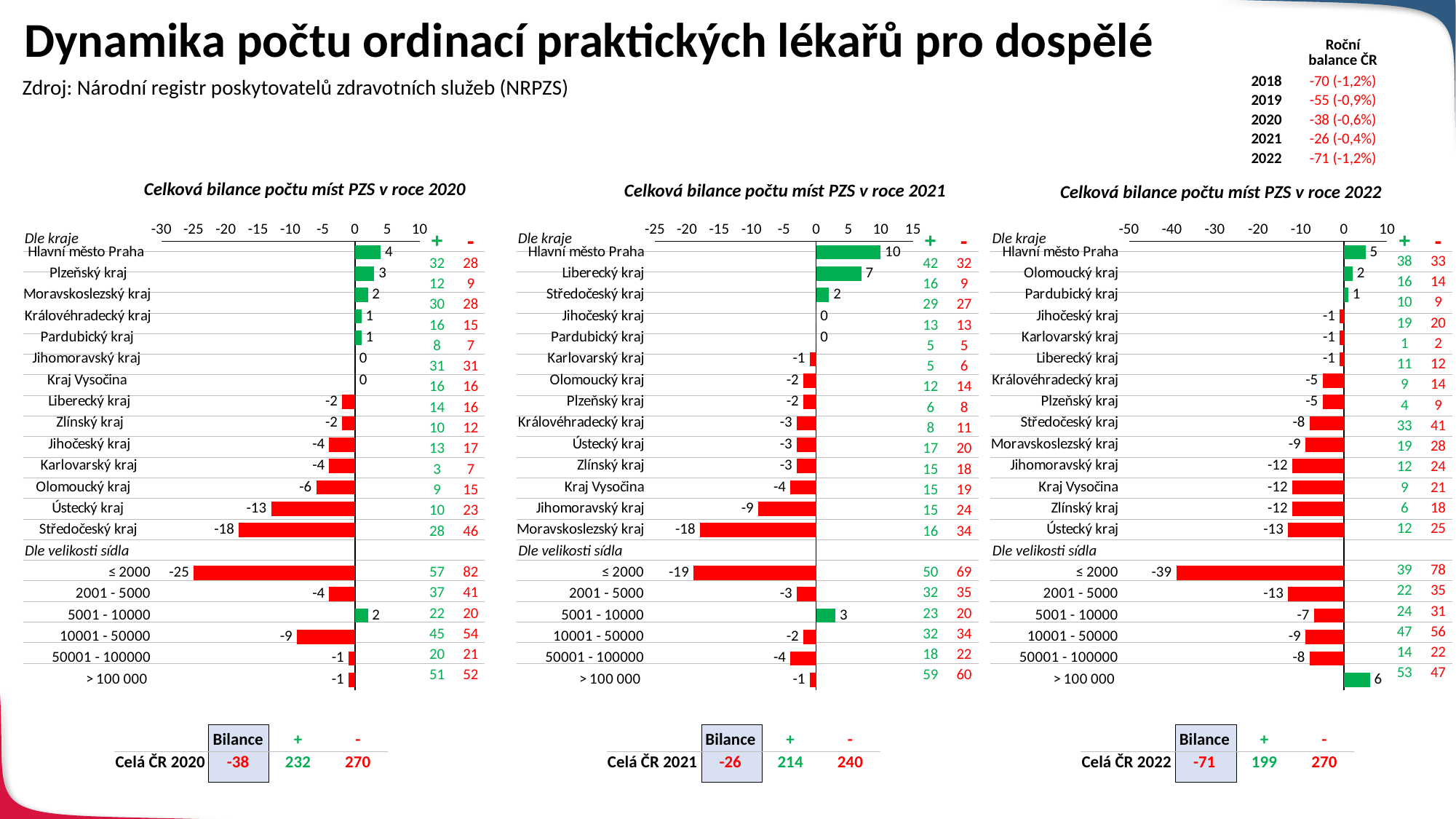
In the chart 'Celková bilance počtu míst PZS v roce 2020', what is the value for Středočeský kraj? -18 In the chart 'Celková bilance počtu míst PZS v roce 2022', what is the difference between the values for Hlavní město Praha and Ústecký kraj? 18 In the chart 'Celková bilance počtu míst PZS v roce 2020', which category has the lowest value? ≤ 2000 In the chart 'Celková bilance počtu míst PZS v roce 2022', what is the value for the category > 100 000? 6 In the chart 'Celková bilance počtu míst PZS v roce 2020', is the value for Ústecký kraj greater or less than -10? less In the chart 'Celková bilance počtu míst PZS v roce 2021', which is larger: the value for Jihomoravský kraj or the value for Moravskoslezský kraj? Jihomoravský kraj In the chart 'Celková bilance počtu míst PZS v roce 2021', what is the value for Liberecký kraj? 7 What kind of chart is 'Celková bilance počtu míst PZS v roce 2021'? bar chart How many categories are plotted in the chart 'Celková bilance počtu míst PZS v roce 2022'? 20 In the chart 'Celková bilance počtu míst PZS v roce 2021', which category has the highest value? Hlavní město Praha In the chart 'Celková bilance počtu míst PZS v roce 2020', what colour are the bars with negative values? red In the chart 'Celková bilance počtu míst PZS v roce 2022', what is the value for the category ≤ 2000? -39